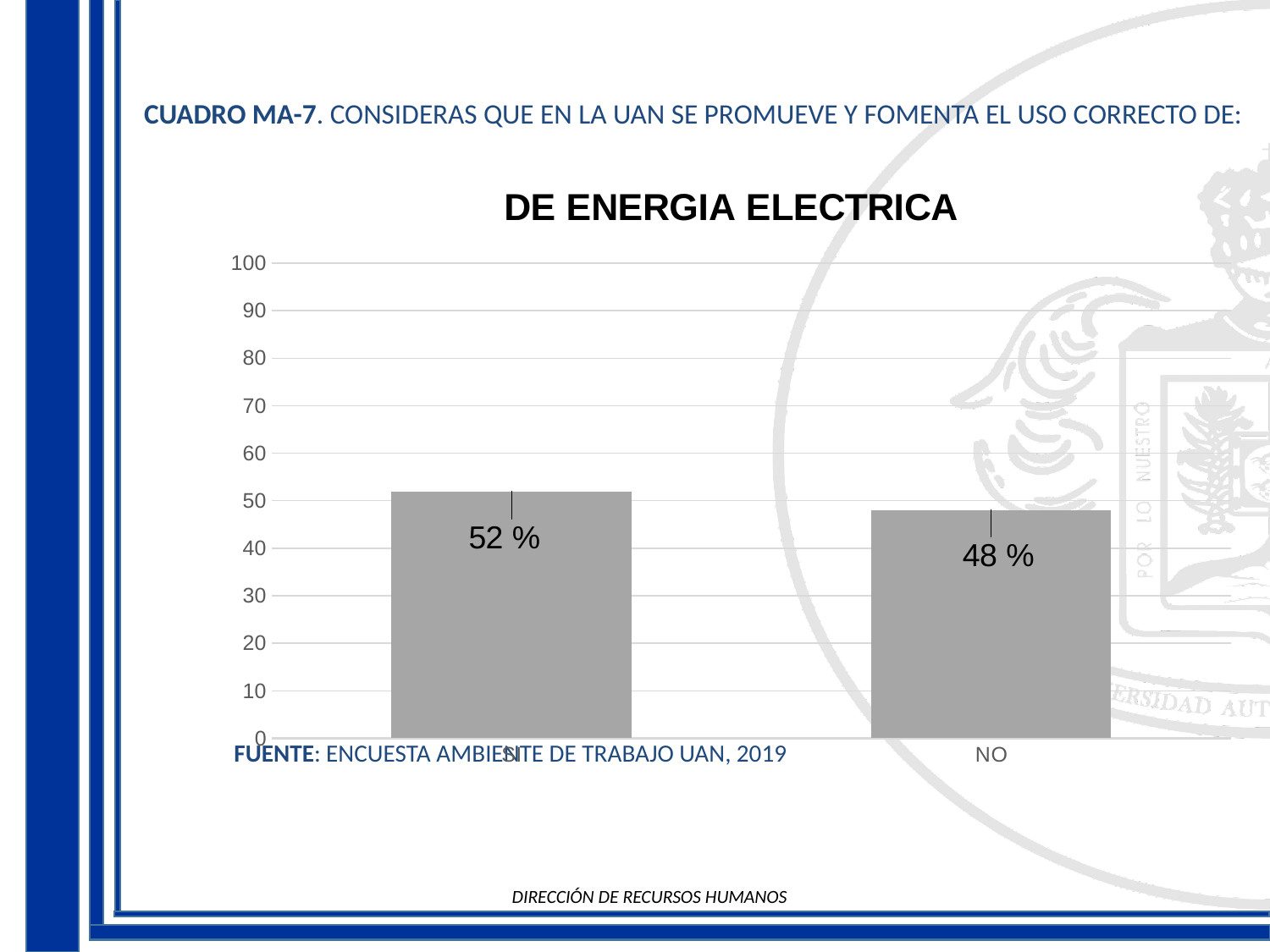
How many bars are plotted in the chart? 2 What is the maximum value shown on the vertical axis of the chart? 100 What type of chart is shown on the slide? bar chart What is the title of the chart? DE ENERGIA ELECTRICA Is the value for NO greater or less than 50? less Which is larger, the left bar or the NO bar? the left bar What is the value shown for the NO bar? 48 % What is the value shown on the left bar of the chart? 52 % What is the difference between the left bar's value and the NO bar's value? 4 % Which category has the lowest value in the chart? NO Which bar is the highest in the chart? the left bar (52 %) Is the value of the left bar greater or less than 50? greater